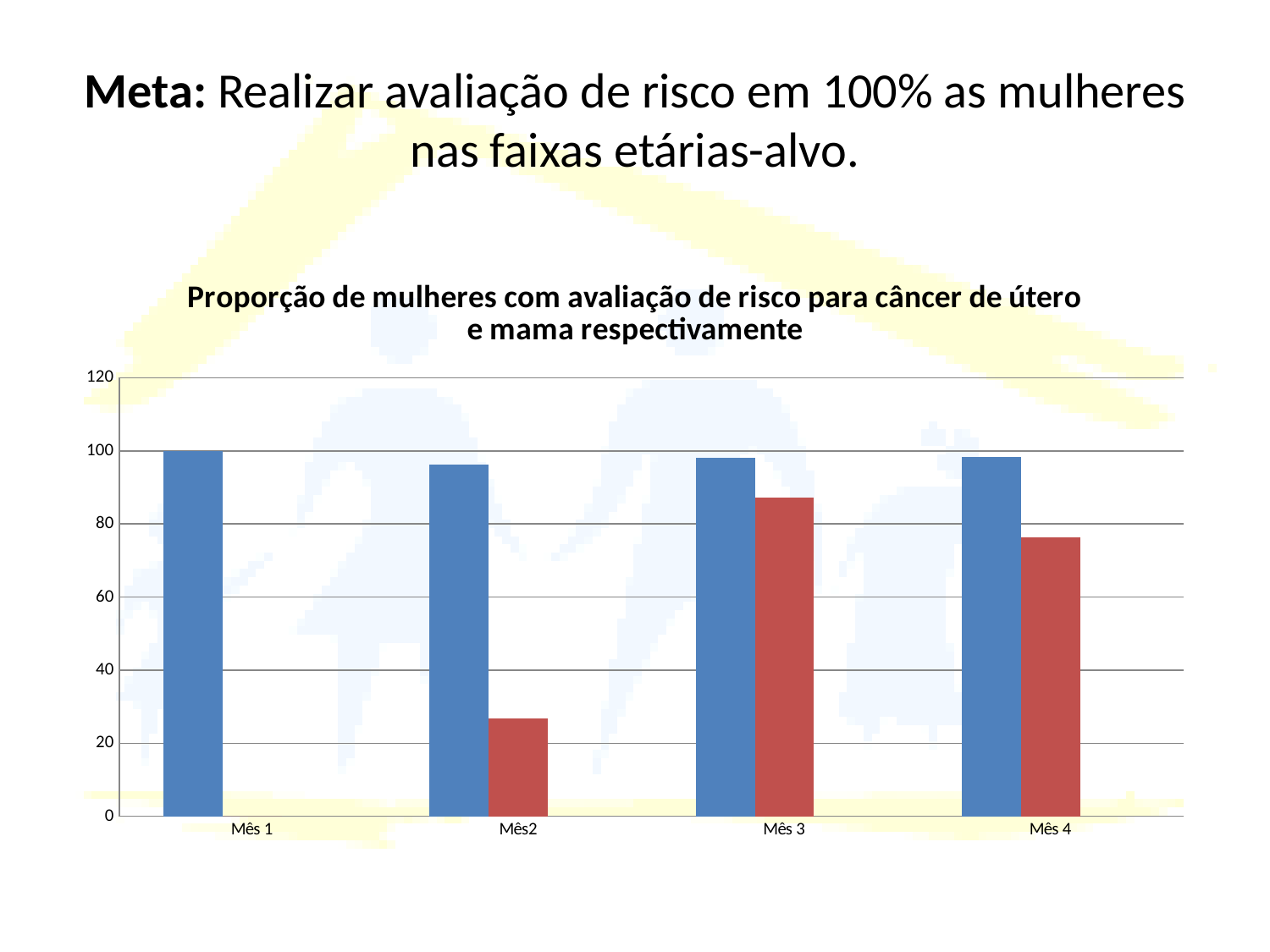
What two colours are used for the bars in the chart? blue and red Is the red bar for Mês 3 larger or smaller than the red bar for Mês 4? larger What is the title of the chart? Proporção de mulheres com avaliação de risco para câncer de útero e mama respectivamente Which category has the highest red bar? Mês 3 Is the value of the blue bar for Mês2 greater or less than 80? greater Among the categories that have a red bar, which has the lowest red bar? Mês2 Is the value of the red bar for Mês2 greater or less than 40? less What is the value of the blue bar for Mês 1? 100 What kind of chart is shown on the slide? bar chart Is the value of the red bar for Mês 3 greater or less than 80? greater How many categories are shown on the x axis of the chart? 4